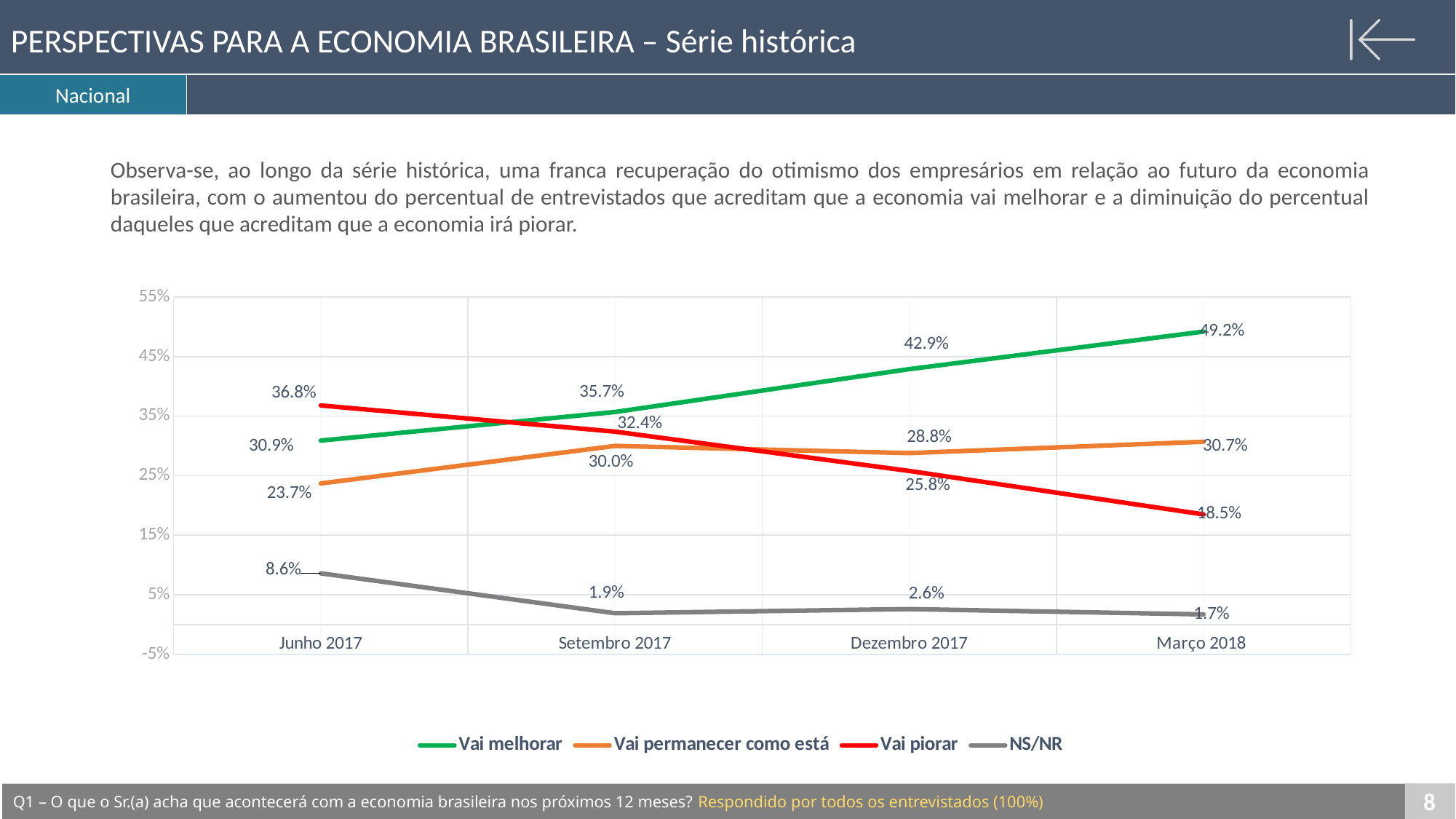
What is the value for Vai piorar in Junho 2017? 36.8% What is the value for NS/NR in Dezembro 2017? 2.6% Which is larger in Junho 2017: Vai melhorar or Vai piorar? Vai piorar What is the value for Vai permanecer como está in Setembro 2017? 30.0% In which period is the Vai piorar series lowest? Março 2018 What kind of chart is shown on the slide? Line chart Does the Vai piorar series rise or fall from Junho 2017 to Março 2018? Fall In which period is the Vai melhorar series highest? Março 2018 How many series does the legend list? 4 What is the difference between Vai melhorar and Vai piorar in Março 2018? 30.7% How many time periods are shown on the x axis? 4 What is the value for Vai melhorar in Março 2018? 49.2%